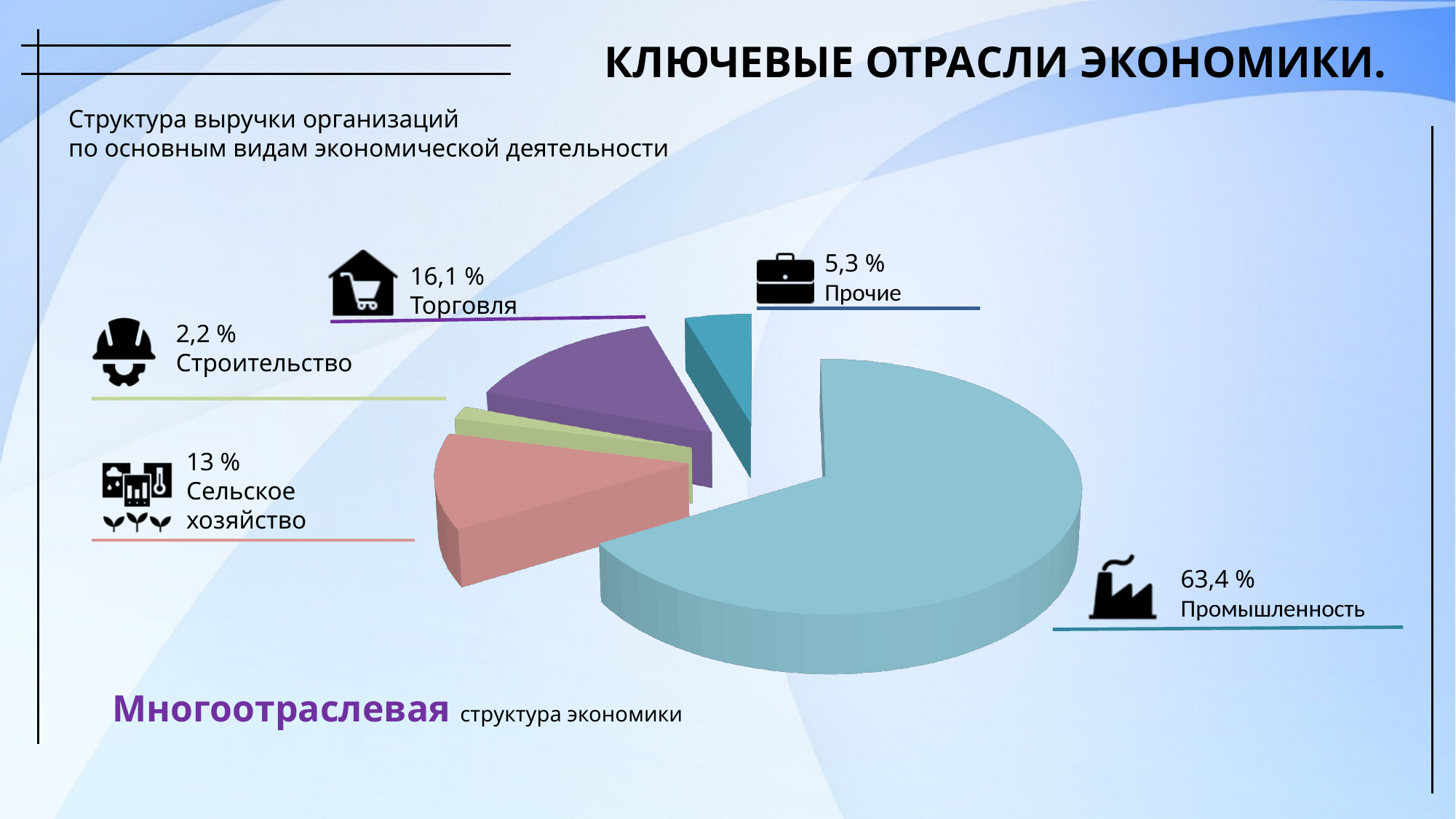
How many slices does the pie chart have? 5 What is the difference in percentage points between Промышленность and Торговля? 47,3 What share of revenue does Промышленность account for? 63,4 % What is the value shown for Торговля? 16,1 % Which is larger, the share for Торговля or the share for Сельское хозяйство? Торговля What is the value shown for Прочие? 5,3 % What is the value shown for Строительство? 2,2 % What is the value shown for Сельское хозяйство? 13 % Which sector has the largest share of the pie? Промышленность What is the difference in percentage points between Прочие and Строительство? 3,1 Which sector has the smallest share of the pie? Строительство What kind of chart is shown on the slide? Pie chart